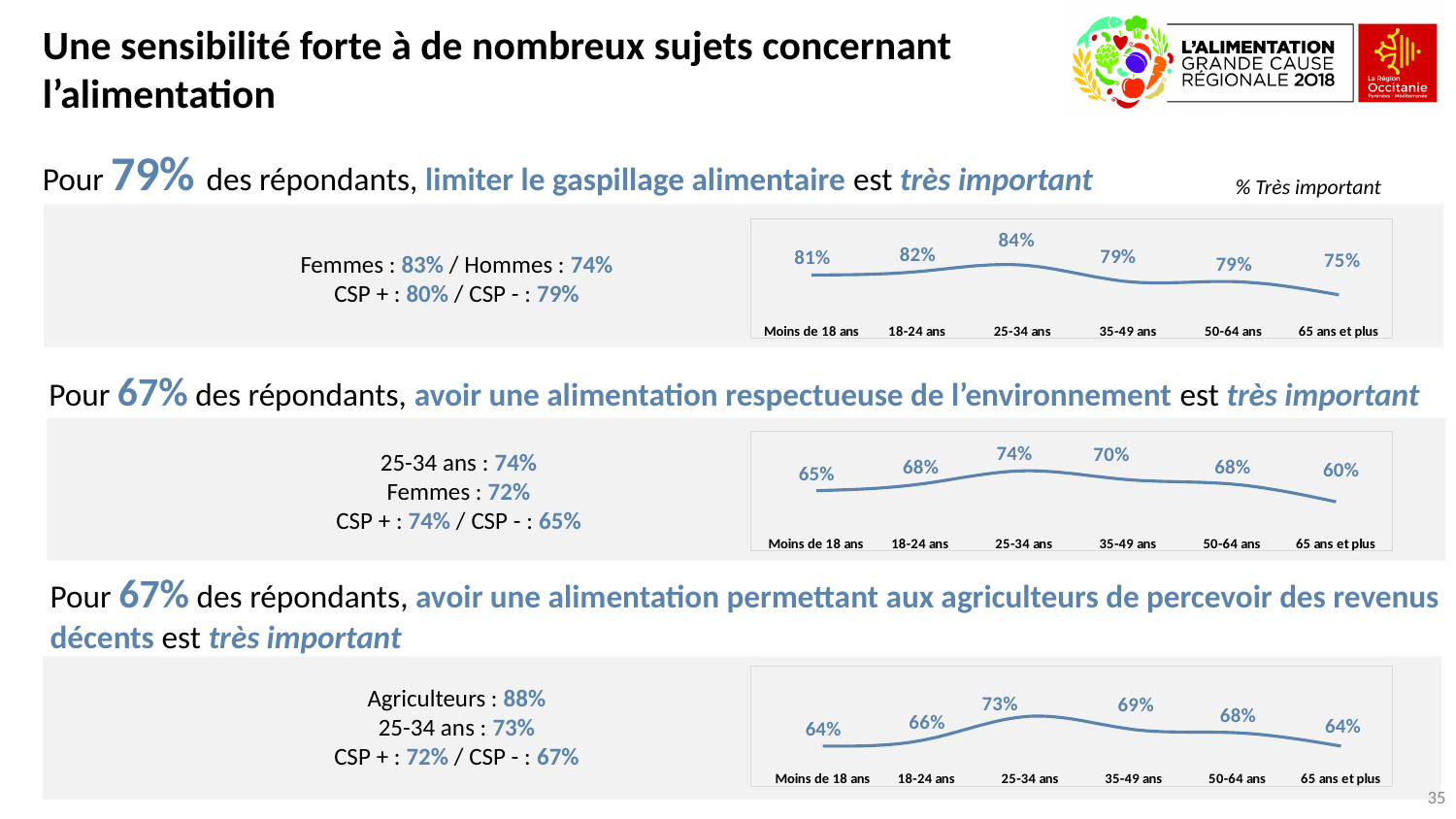
In the middle chart (alimentation respectueuse de l'environnement), which is larger: the value for 18-24 ans or the value for 65 ans et plus? 18-24 ans In the bottom chart (revenus décents pour les agriculteurs), what is the value for 35-49 ans? 69% In the top chart (limiter le gaspillage alimentaire), what is the value for 25-34 ans? 84% In the bottom chart (revenus décents pour les agriculteurs), which age group has the highest value? 25-34 ans How many age groups are plotted in the top chart? 6 In the middle chart (alimentation respectueuse de l'environnement), what is the value for Moins de 18 ans? 65% In the top chart (limiter le gaspillage alimentaire), what is the difference between the values for 25-34 ans and 65 ans et plus? 9 percentage points In the bottom chart (revenus décents pour les agriculteurs), what is the difference between the values for 25-34 ans and 18-24 ans? 7 percentage points What type of chart is used in the middle chart? Line chart In the top chart (limiter le gaspillage alimentaire), which age group has the lowest value? 65 ans et plus In the middle chart (alimentation respectueuse de l'environnement), which age group has the highest value? 25-34 ans In the middle chart, do the values rise or fall from 25-34 ans to 65 ans et plus? Fall